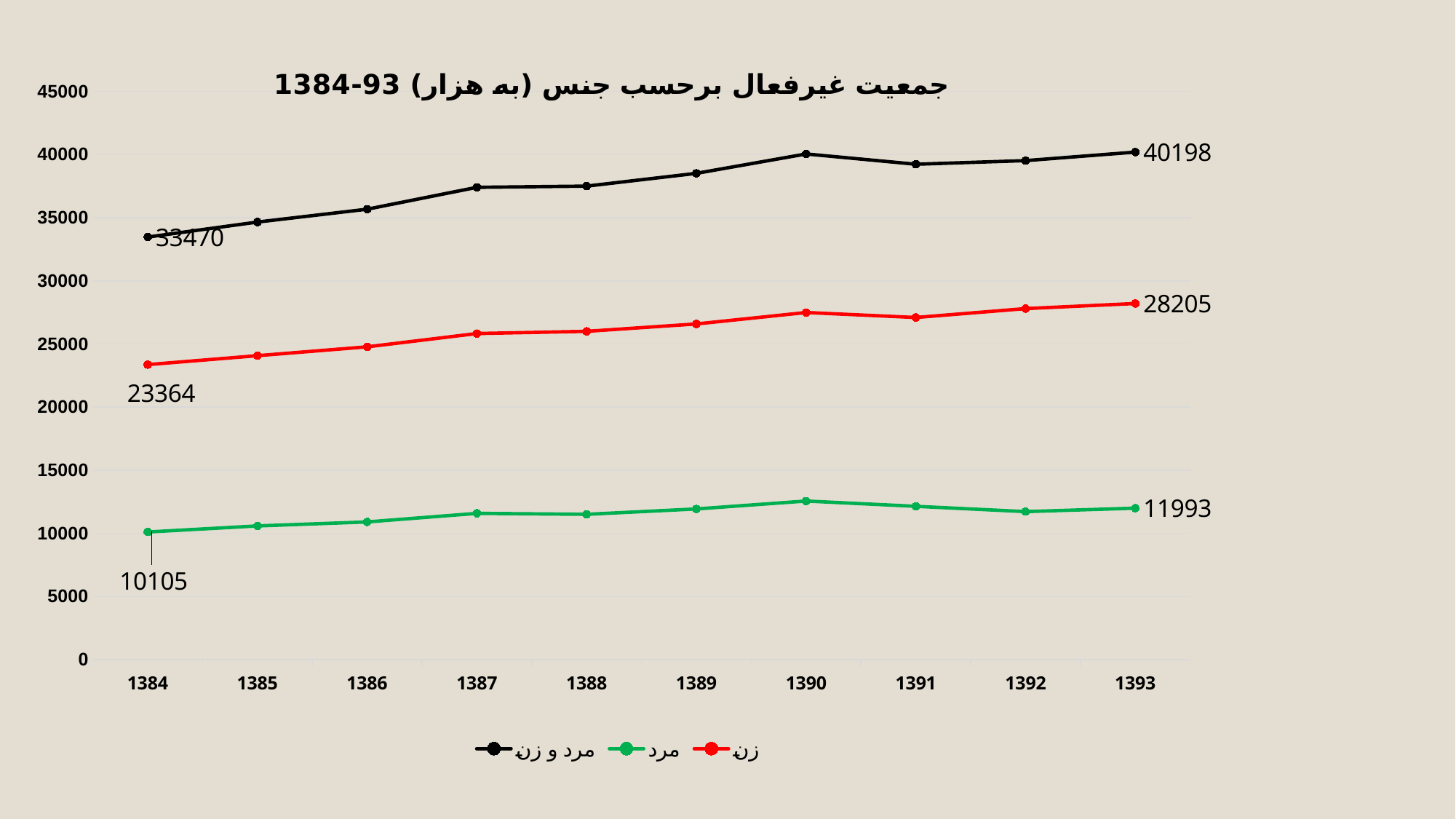
How many years are shown on the x axis? 10 What type of chart is shown on the slide? line chart By how much did the زن series increase from 1384 to 1393? 4841 What is the value of the مرد و زن series in 1393? 40198 Which series has the highest values across all years? مرد و زن By how much did the مرد series increase from 1384 to 1393? 1888 Does the زن series generally rise or fall from 1384 to 1393? rise Is the value of the مرد series in 1390 greater or less than 15000? less How many series does the legend list? 3 What is the value of the زن series in 1384? 23364 What is the value of the مرد series in 1393? 11993 What is the value of the مرد و زن series in 1384? 33470